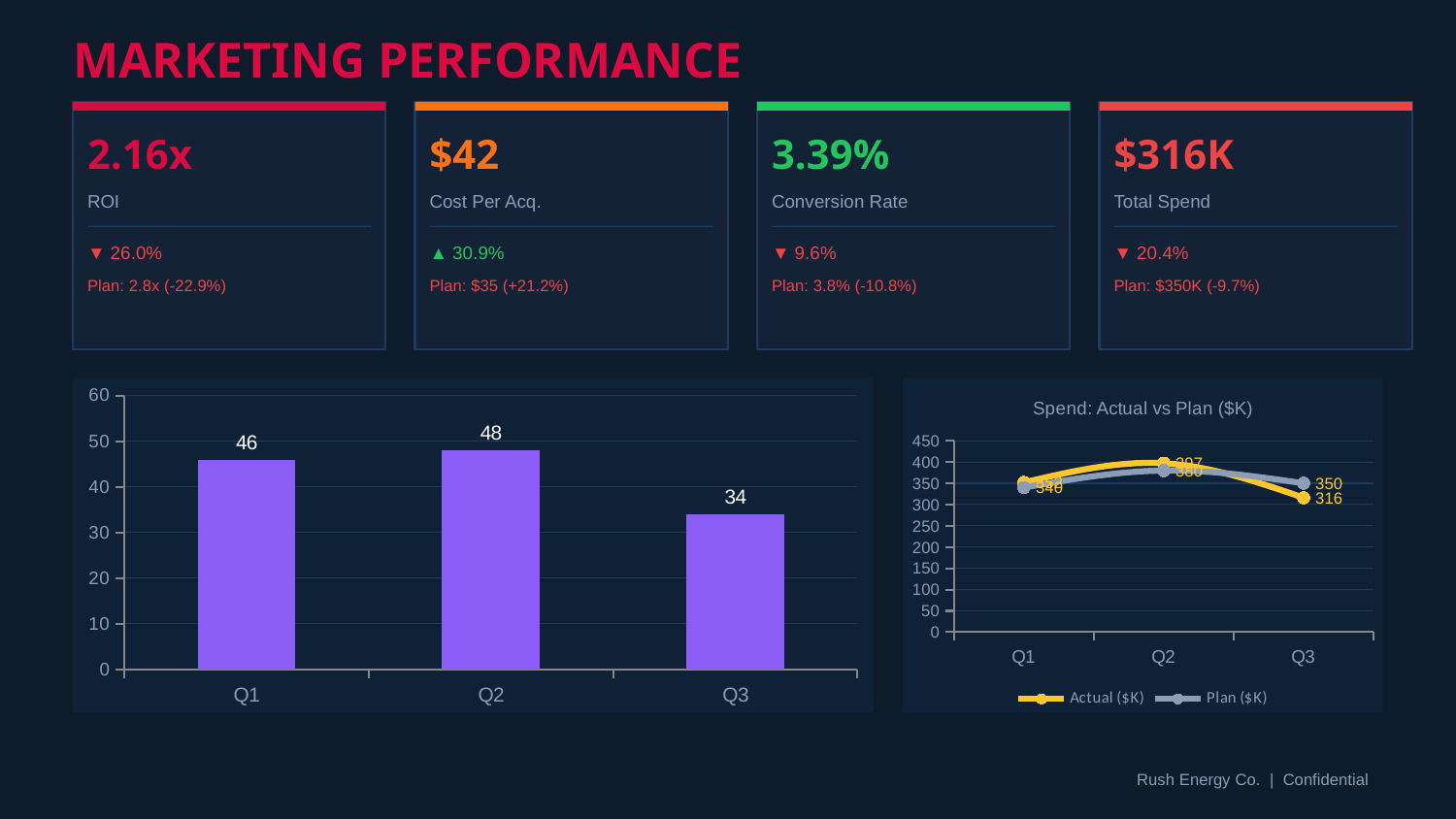
In the bar chart on the left, what is the value for Q2? 48 In the 'Spend: Actual vs Plan ($K)' chart, what is the Actual value for Q3? 316 In the bar chart on the left, how many quarters are shown? 3 In the 'Spend: Actual vs Plan ($K)' chart, how many series does the legend list? 2 In the 'Spend: Actual vs Plan ($K)' chart, is the Actual value for Q1 greater or less than 300? greater In the bar chart on the left, what is the difference between the values for Q1 and Q3? 12 In the 'Spend: Actual vs Plan ($K)' chart, what is the Plan value for Q3? 350 In the bar chart on the left, does the value rise or fall from Q2 to Q3? Fall In the bar chart on the left, which quarter has the highest value? Q2 What kind of chart is the chart on the left of the slide? Bar chart In the bar chart on the left, which quarter has the lowest value? Q3 In the 'Spend: Actual vs Plan ($K)' chart, which is larger for Q3, Actual or Plan? Plan